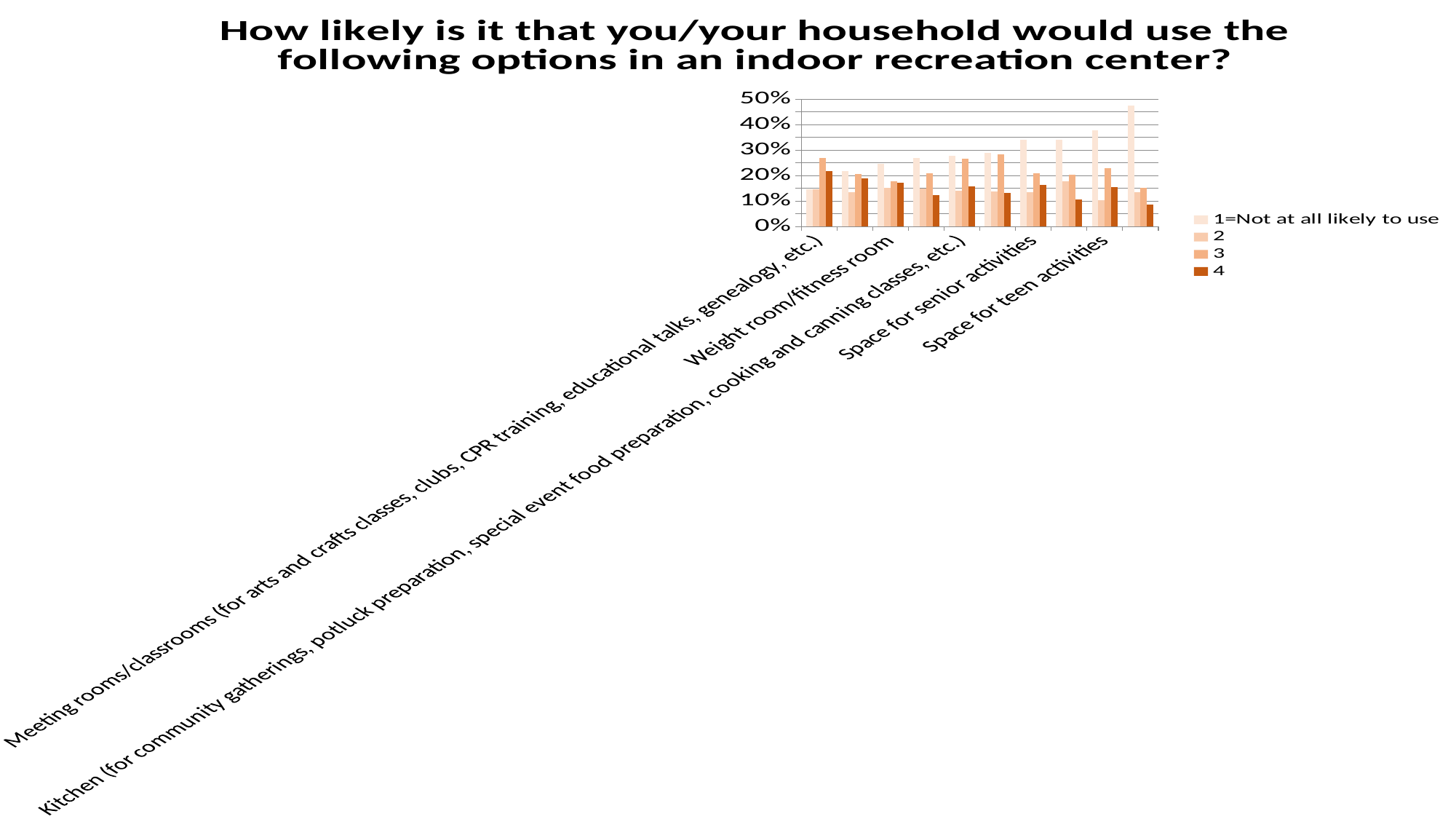
What is the title of the chart? How likely is it that you/your household would use the following options in an indoor recreation center? For Meeting rooms/classrooms, which is larger: the value for series 3 or the value for series 2? series 3 How many series does the legend list? 4 Is the value for series 3 for Meeting rooms/classrooms greater or less than 20%? greater Is the tallest bar on the chart greater or less than 40%? greater Is the value for series 2 for Meeting rooms/classrooms greater or less than 20%? less What kind of chart is shown on the slide? bar chart What is the highest value shown on the vertical axis? 50% What is the legend label for the first series? 1=Not at all likely to use